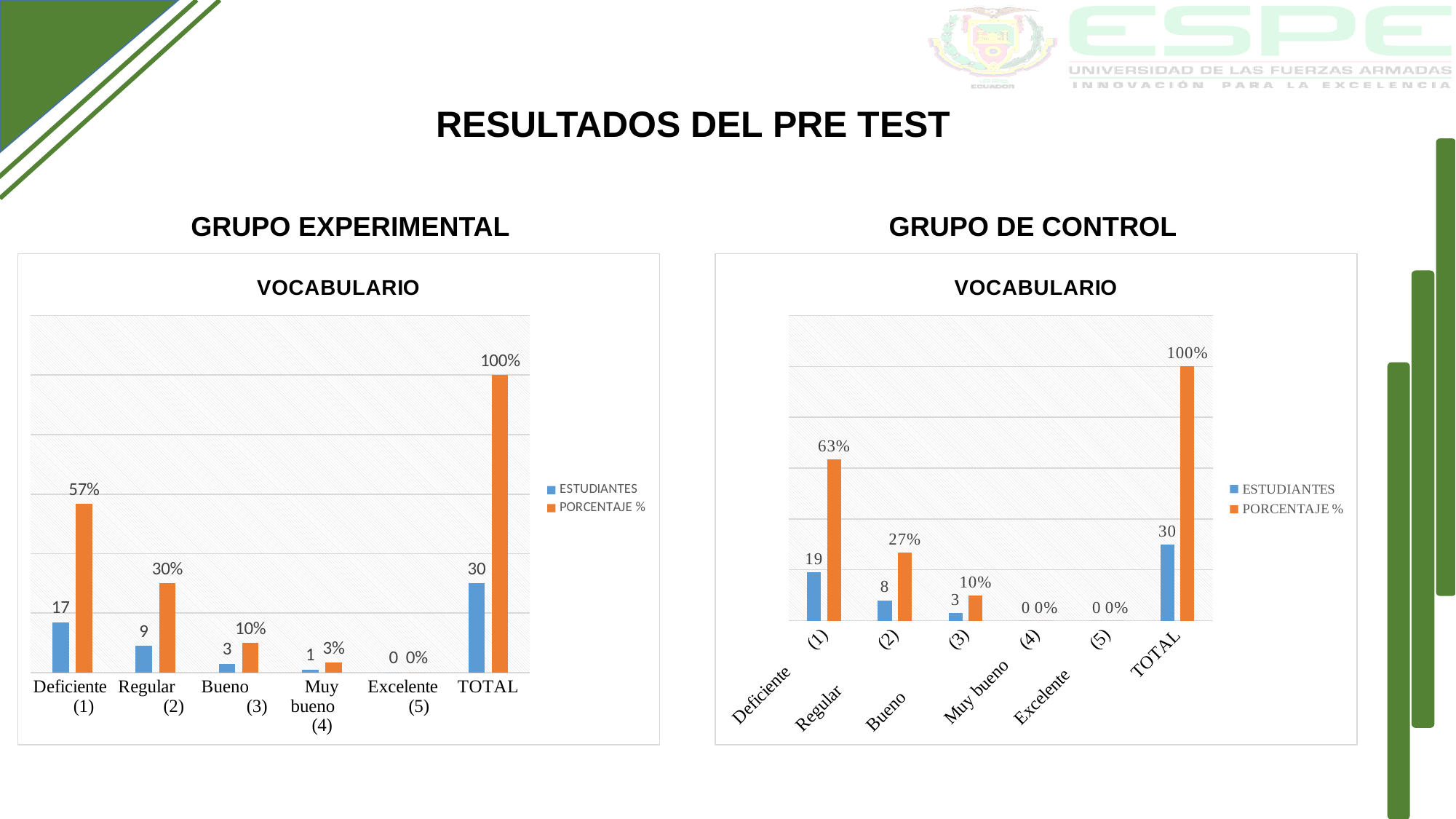
In the GRUPO EXPERIMENTAL chart on the left, what is the PORCENTAJE % value for Regular (2)? 30% What type of chart is the GRUPO EXPERIMENTAL chart on the left? Bar chart In the GRUPO DE CONTROL chart on the right, what is the ESTUDIANTES value for Deficiente (1)? 19 Which chart has the larger ESTUDIANTES value for Deficiente (1), GRUPO EXPERIMENTAL or GRUPO DE CONTROL? GRUPO DE CONTROL In the GRUPO EXPERIMENTAL chart on the left, which category other than TOTAL has the highest ESTUDIANTES value? Deficiente (1) In the GRUPO EXPERIMENTAL chart on the left, what is the ESTUDIANTES value for Deficiente (1)? 17 In the GRUPO EXPERIMENTAL chart on the left, how many categories are shown on the x axis? 6 In the GRUPO EXPERIMENTAL chart on the left, what is the difference in ESTUDIANTES between Regular (2) and Bueno (3)? 6 In the GRUPO DE CONTROL chart on the right, what is the difference in ESTUDIANTES between Deficiente (1) and Regular (2)? 11 What is the title shown inside the GRUPO DE CONTROL chart on the right? VOCABULARIO In the GRUPO DE CONTROL chart on the right, what is the PORCENTAJE % value for Regular (2)? 27% How many series does the legend of the GRUPO DE CONTROL chart on the right list? 2